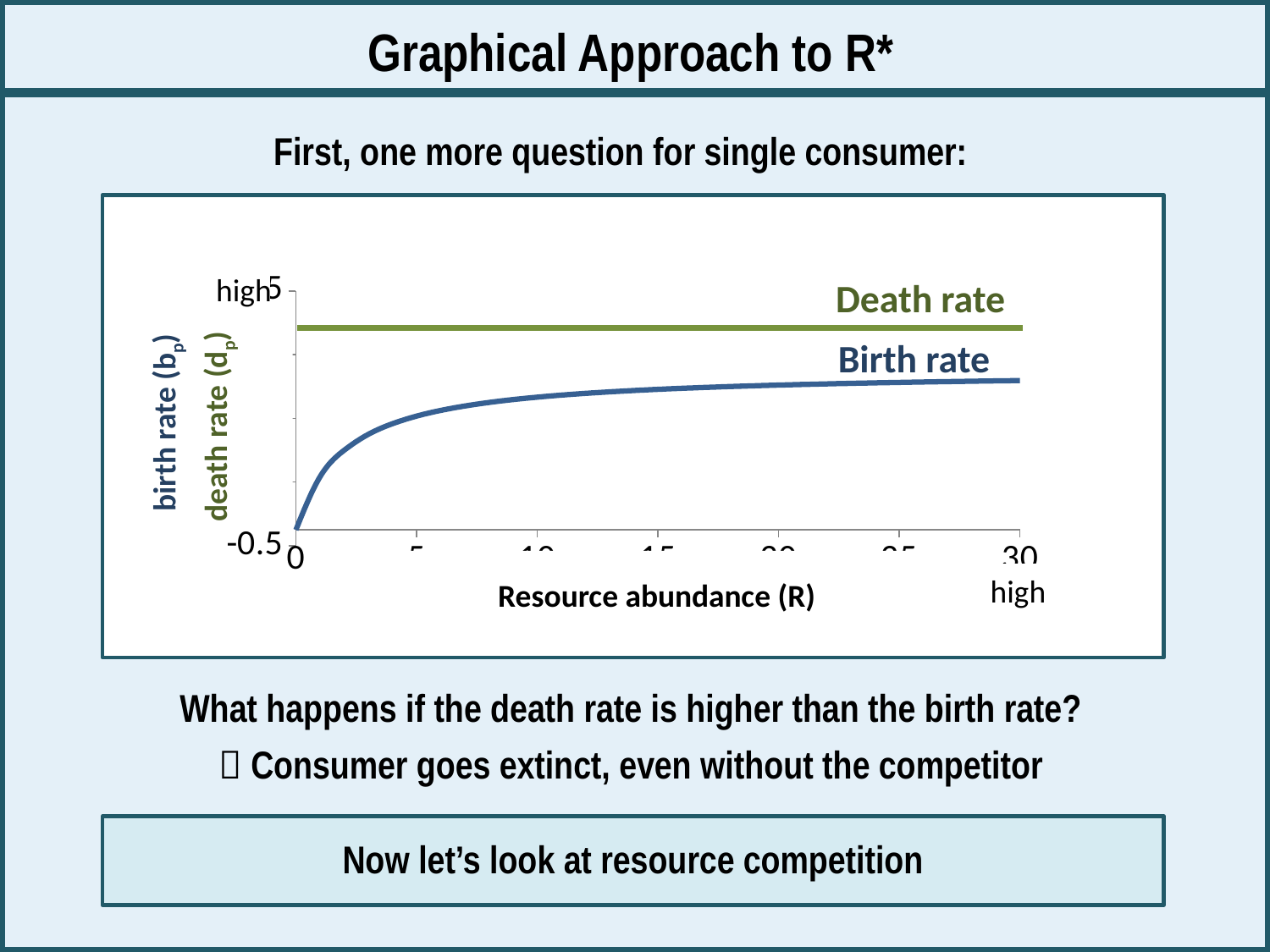
Which series is drawn as a curve that flattens out at high resource abundance? Birth rate What kind of chart is shown on the slide? line chart Does the birth rate rise or fall as resource abundance increases? rises Which two series are labelled on the chart? Death rate and Birth rate What is the label of the x axis? Resource abundance (R) Is the birth rate at a resource abundance of 30 greater or less than -0.5? greater At a resource abundance of 30, is the birth rate greater or less than the death rate? less What is the highest value shown on the x axis? 30 How many series are plotted on the chart? 2 Is the death rate greater or less than 5 on the y axis? less Does the death rate change as resource abundance increases? No, it stays constant Which series is higher across the whole range of resource abundance, Death rate or Birth rate? Death rate